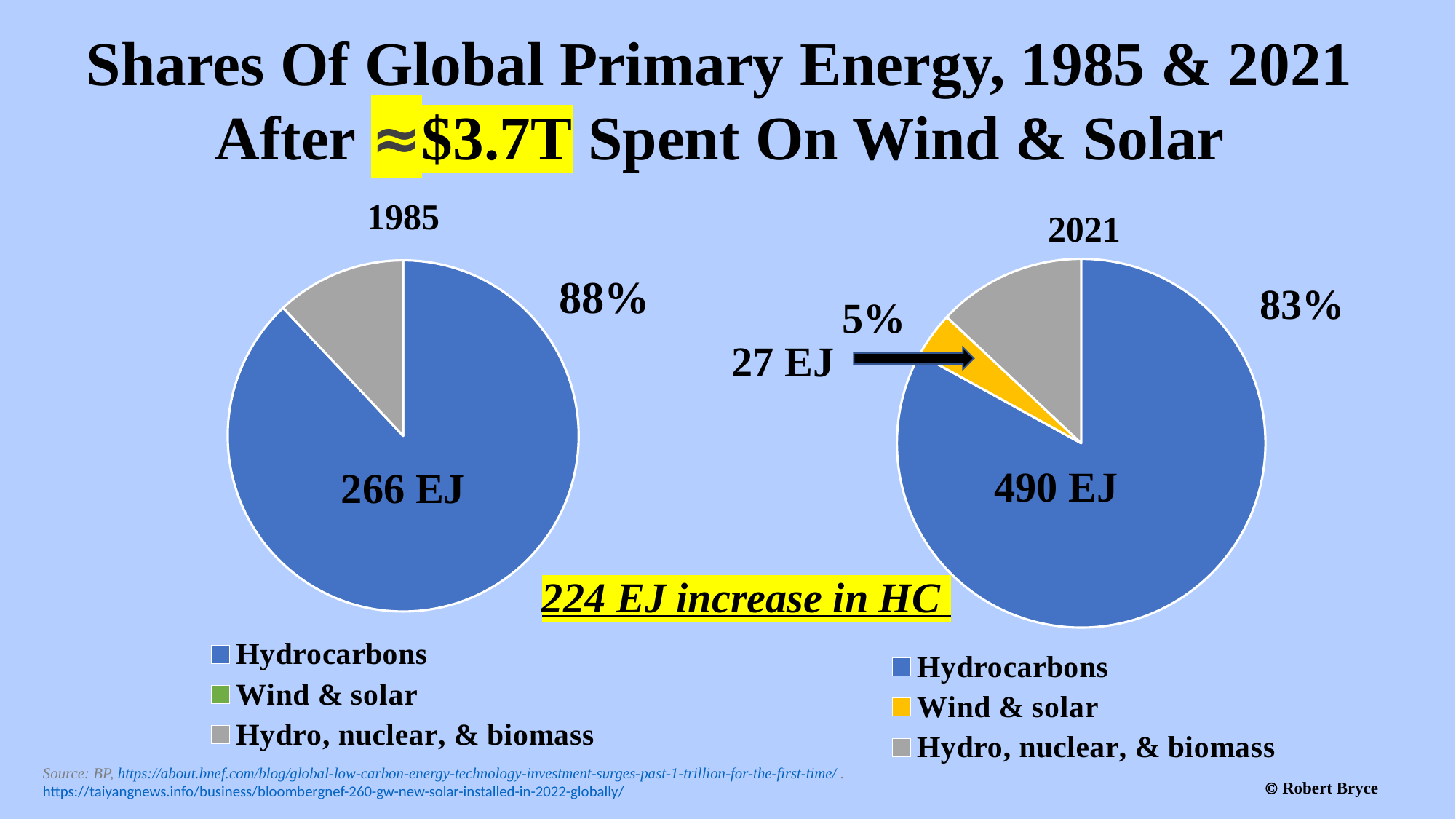
What type of charts are shown on the slide? Pie charts In the 2021 chart, how many EJ are labelled for Wind & solar? 27 EJ In the 2021 chart, what share is labelled for Wind & solar? 5% Is the Hydrocarbons share larger in the 1985 chart or the 2021 chart? 1985 What is the difference in EJ between the Hydrocarbons values in the 2021 and 1985 charts? 224 EJ How many entries does the legend of the 2021 chart list? 3 In the 2021 chart, what share of global primary energy is labelled for Hydrocarbons? 83% In the 1985 chart, how many EJ are labelled for Hydrocarbons? 266 EJ In the 2021 chart, which category has the smallest slice? Wind & solar In the 2021 chart, which category has the largest slice? Hydrocarbons In the 1985 chart, what share of global primary energy is labelled for Hydrocarbons? 88% In the 2021 chart, how many EJ are labelled for Hydrocarbons? 490 EJ